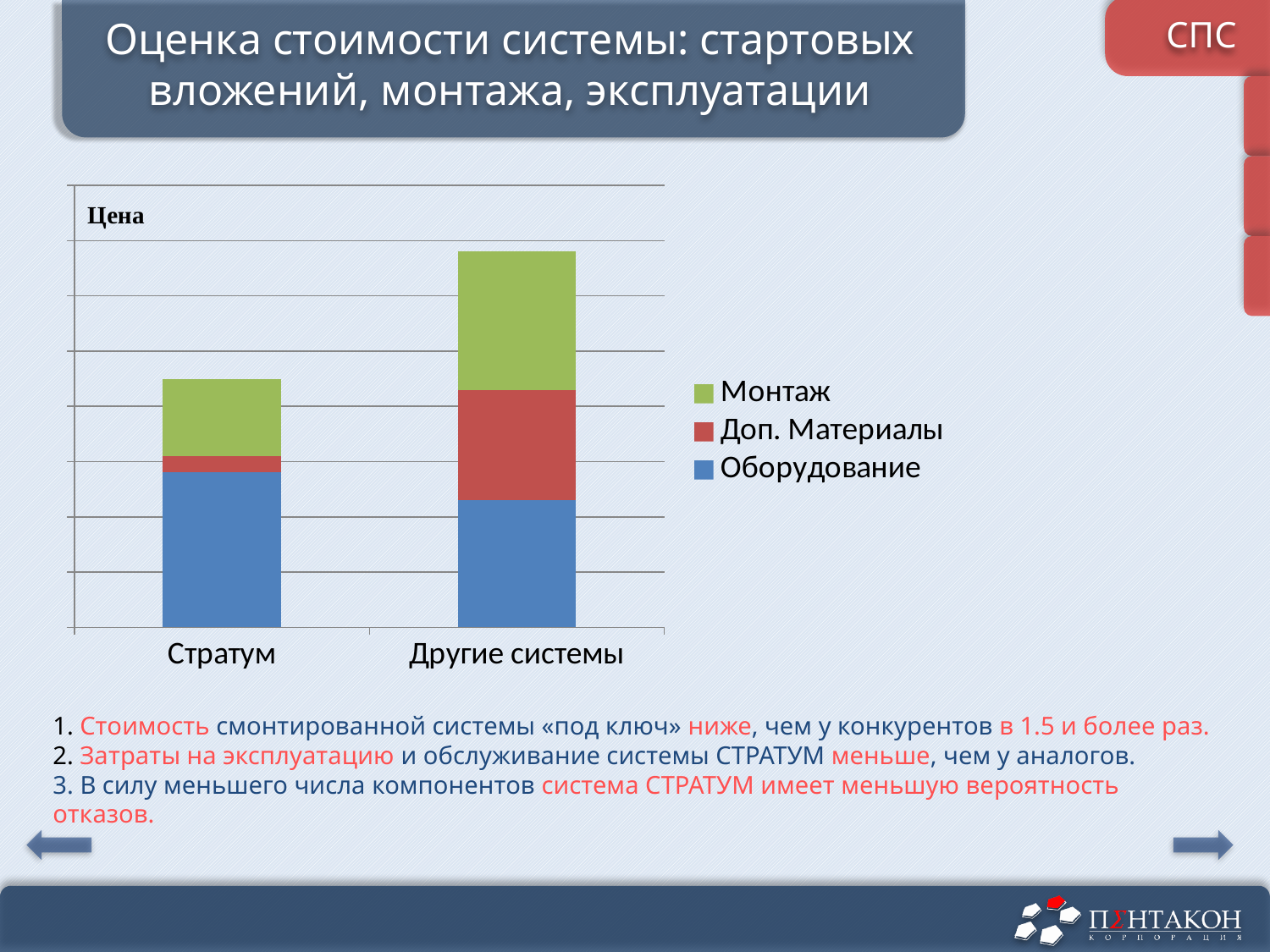
Within the Стратум bar, which series has the largest segment? Оборудование What label is shown at the top left of the chart's plot area? Цена Which series is shown in green in the chart's legend? Монтаж Which category has the shorter stacked bar overall? Стратум Which category has the larger Монтаж segment, Стратум or Другие системы? Другие системы How many categories are shown on the x axis of the chart? 2 Which category has the larger Доп. Материалы segment, Стратум or Другие системы? Другие системы What kind of chart is shown on the slide? Stacked bar chart Within the Стратум bar, which series has the smallest segment? Доп. Материалы How many series does the chart's legend list? 3 Which category has the taller stacked bar overall? Другие системы Which category has the larger Оборудование segment, Стратум or Другие системы? Стратум